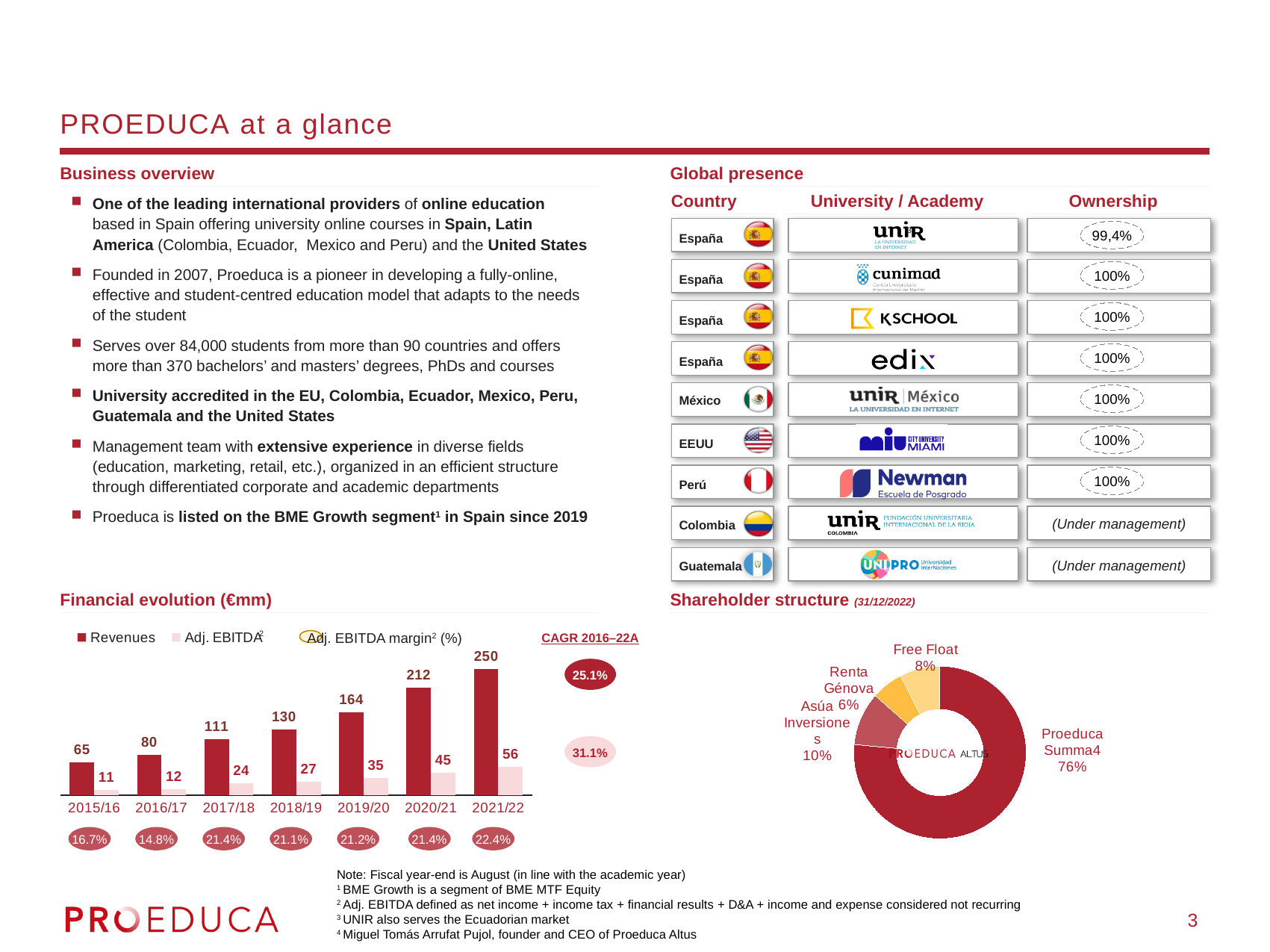
What type of chart is the Financial evolution chart? bar chart In the Financial evolution chart, do Revenues rise or fall from 2015/16 to 2021/22? rise In the Financial evolution chart, what is the difference between Revenues in 2020/21 and 2019/20? 48 In the Financial evolution chart, what was Adj. EBITDA in 2019/20? 35 In the Shareholder structure chart, which shareholder has the smallest share? Renta Génova In the Shareholder structure chart, what share is held by Proeduca Summa? 76% In the Financial evolution chart, which year has the lowest Revenues? 2015/16 In the Financial evolution chart, which year has the highest Adj. EBITDA? 2021/22 In the Financial evolution chart, what were Revenues in 2021/22? 250 In the Financial evolution chart, how many fiscal years are shown on the x axis? 7 In the Financial evolution chart, what is the Adj. EBITDA margin shown for 2016/17? 14.8% In the Financial evolution chart, is Adj. EBITDA higher in 2017/18 or in 2018/19? 2018/19